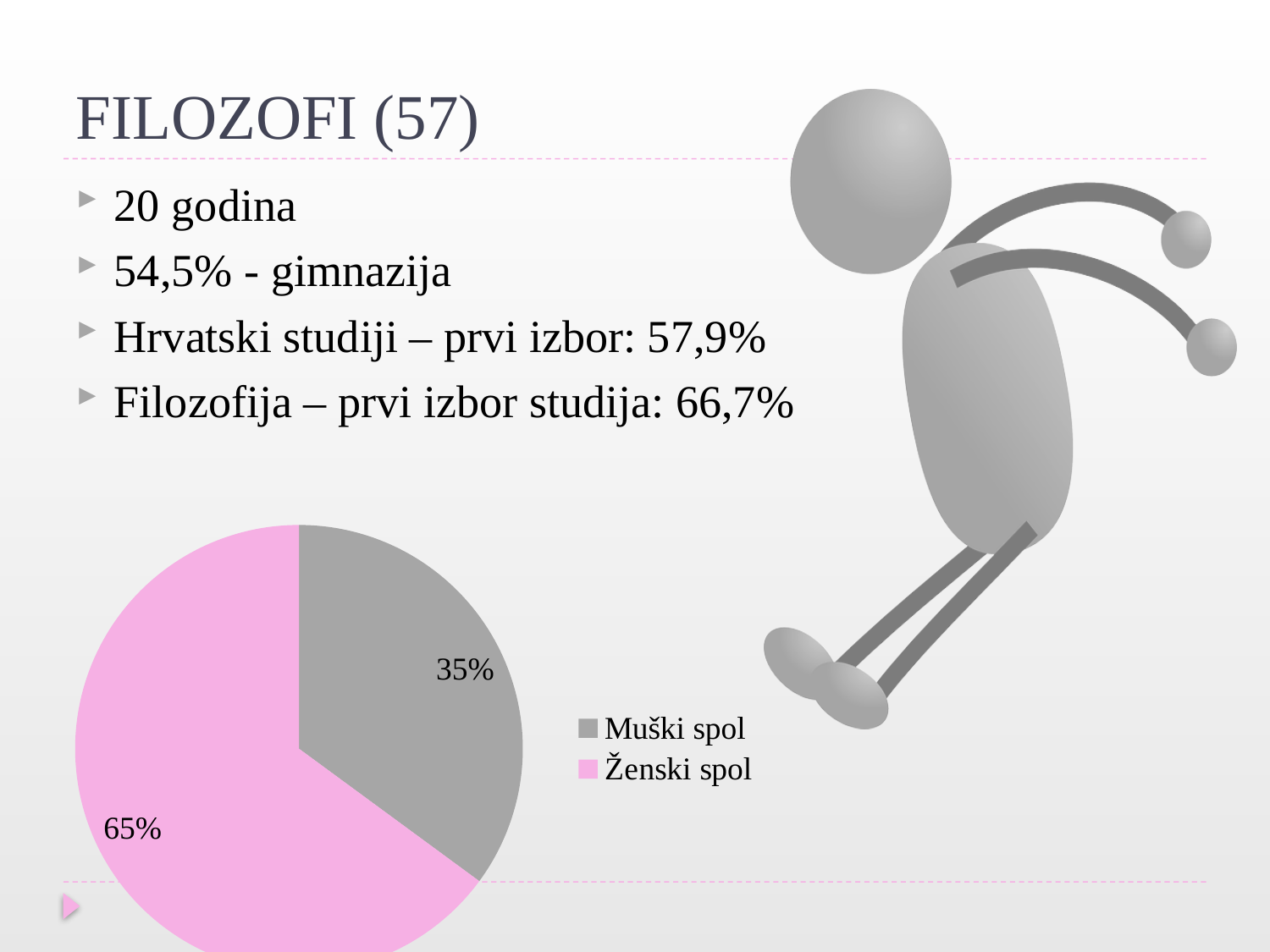
Which category has the smallest share of the pie chart? Muški spol What share of the pie does Ženski spol take? 65% How many entries does the legend of the pie chart list? 2 Which is larger in the pie chart, Muški spol or Ženski spol? Ženski spol What is the value for Ženski spol in the pie chart? 65% Which category has the largest share of the pie chart? Ženski spol What is the difference between the shares of Ženski spol and Muški spol? 30% What colour represents Muški spol in the pie chart? grey How many categories does the pie chart have? 2 What is the value for Muški spol in the pie chart? 35% What colour represents Ženski spol in the pie chart? pink What kind of chart is shown on the slide? pie chart